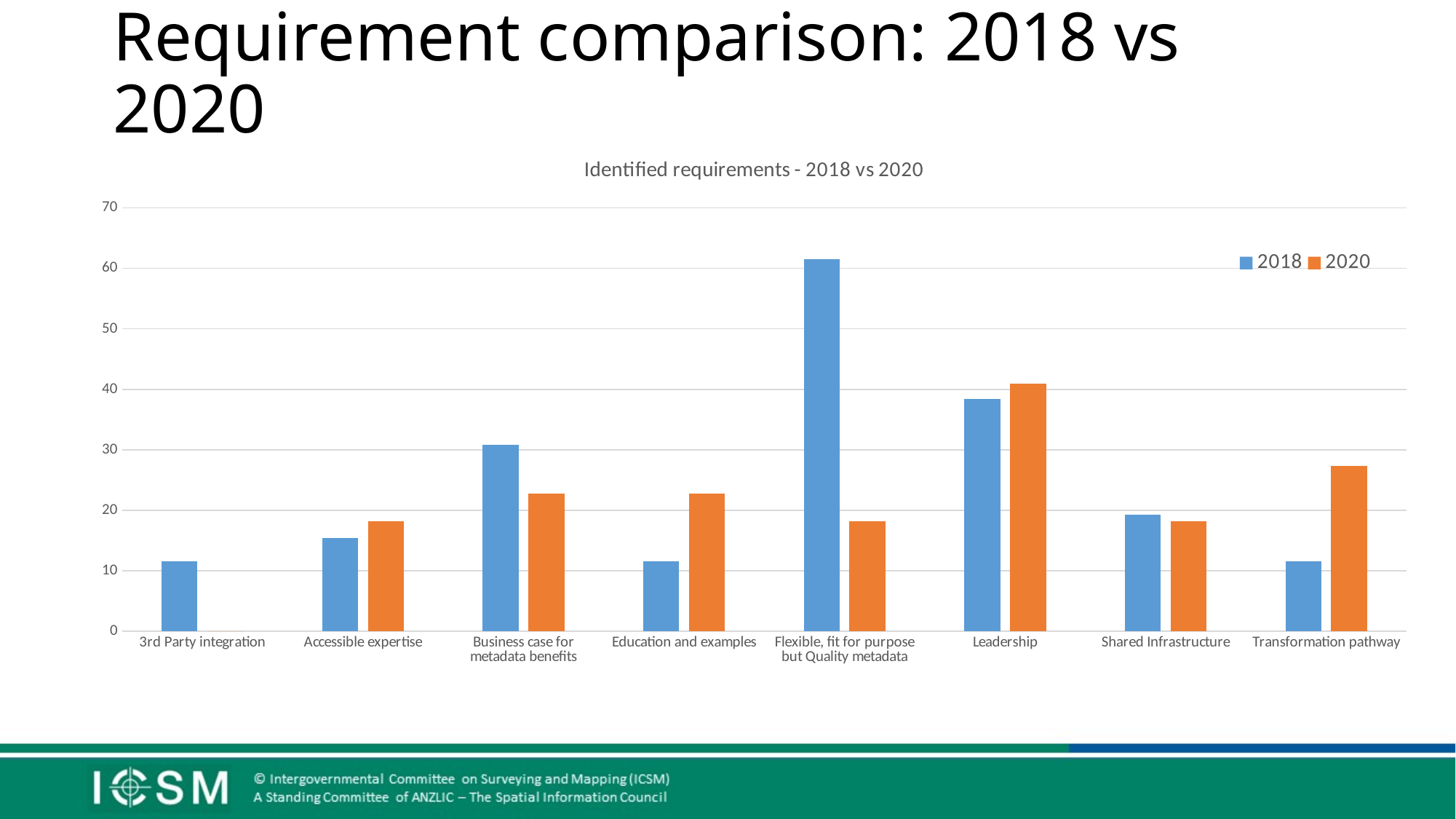
Is the 2018 value for Flexible, fit for purpose but Quality metadata greater or less than 60? greater What is the title of the chart? Identified requirements - 2018 vs 2020 Is the 2018 value for Education and examples greater or less than 20? less How many requirement categories are shown on the x axis? 8 Which category has the highest 2018 value? Flexible, fit for purpose but Quality metadata Which category has the highest 2020 value? Leadership What kind of chart is shown on the slide? bar chart Is the 2020 value for Transformation pathway greater or less than 20? greater For Business case for metadata benefits, which year has the larger value, 2018 or 2020? 2018 For Education and examples, which year has the larger value, 2018 or 2020? 2020 How many series does the legend list? 2